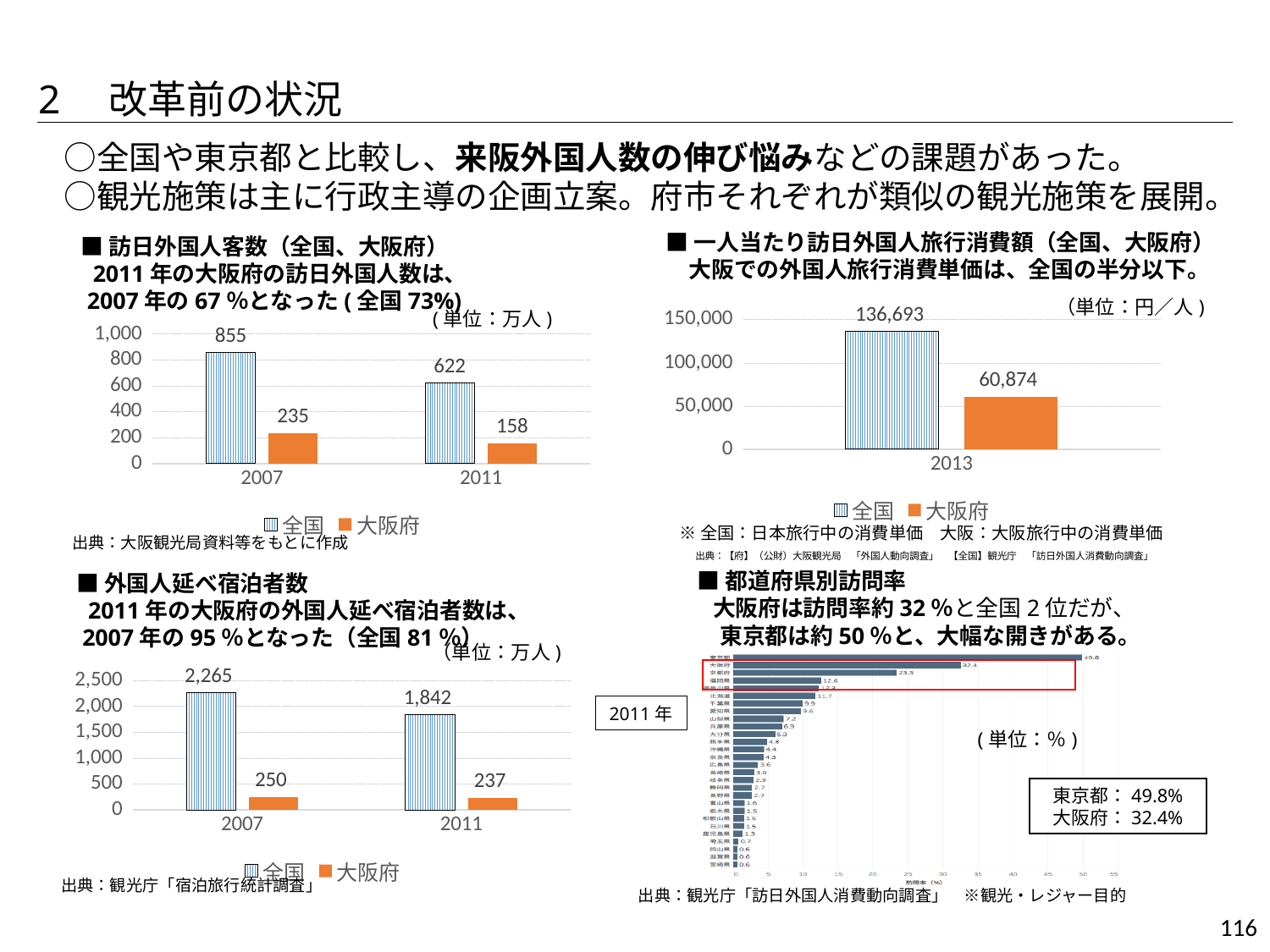
In the chart titled 訪日外国人客数（全国、大阪府）, what is the difference between the 全国 values for 2007 and 2011? 233 In the chart titled 一人当たり訪日外国人旅行消費額（全国、大阪府）, how many series does the legend list? 2 In the chart titled 訪日外国人客数（全国、大阪府）, what is the value for 大阪府 in 2011? 158 In the chart titled 訪日外国人客数（全国、大阪府）, what is the value for 全国 in 2007? 855 In the chart titled 外国人延べ宿泊者数, which is larger: 大阪府 in 2007 or 大阪府 in 2011? 大阪府 in 2007 In the chart titled 一人当たり訪日外国人旅行消費額（全国、大阪府）, what is the difference between the 全国 and 大阪府 values? 75,819 In the chart titled 訪日外国人客数（全国、大阪府）, does the 全国 value rise or fall from 2007 to 2011? fall In the chart titled 外国人延べ宿泊者数, what is the value for 全国 in 2011? 1,842 In the chart titled 都道府県別訪問率, which prefecture has the highest visit rate? 東京都 In the chart titled 外国人延べ宿泊者数, what is the difference between the 大阪府 values for 2007 and 2011? 13 In the chart titled 一人当たり訪日外国人旅行消費額（全国、大阪府）, what is the value for 大阪府 in 2013? 60,874 What kind of chart is the chart titled 都道府県別訪問率? bar chart